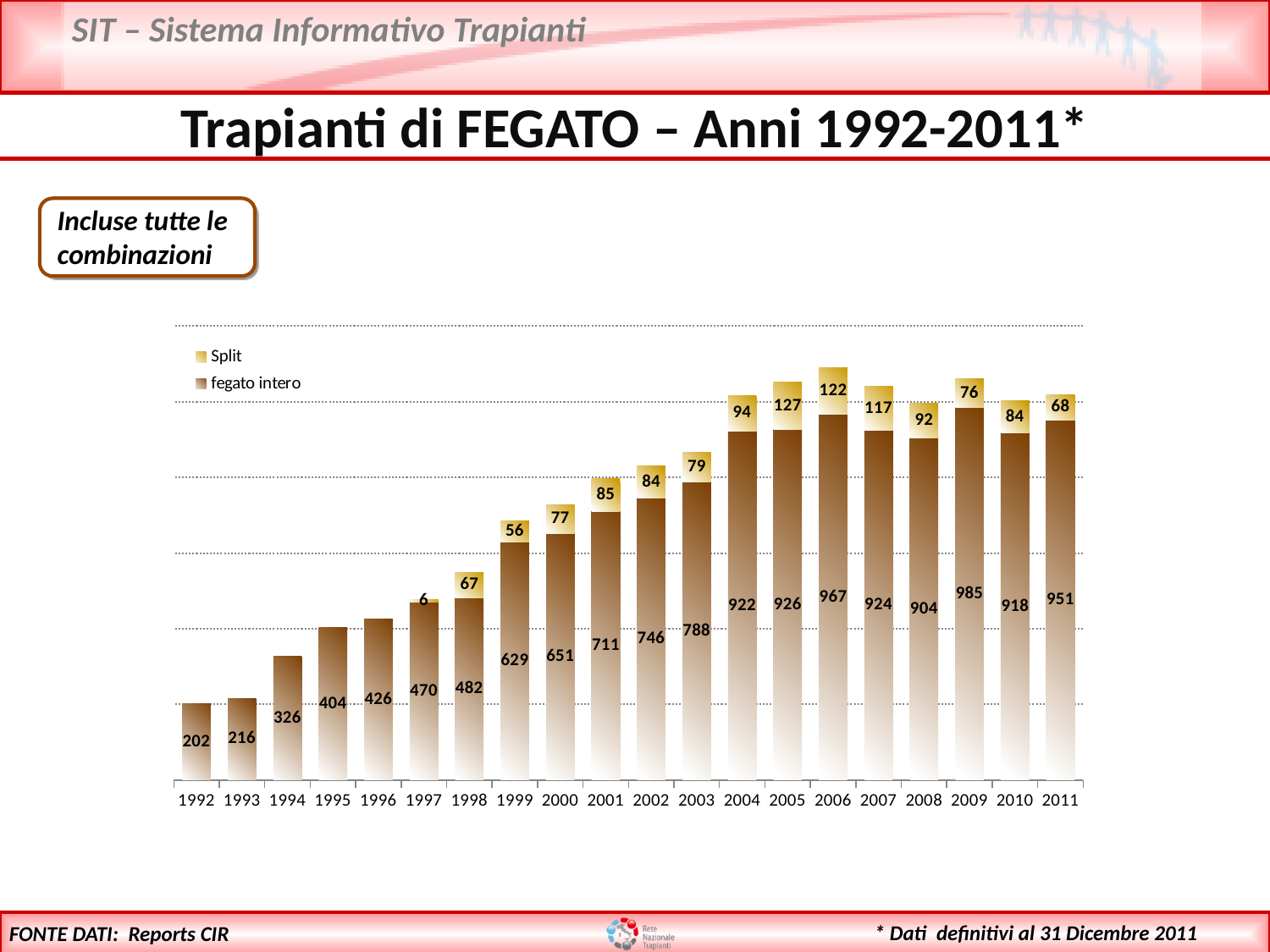
What is the total of the stacked bar for 2006? 1089 What is the 'Split' value for 2005? 127 What is the value of 'fegato intero' for 2006? 967 How many series does the legend list? 2 How many years are shown on the x axis? 20 What kind of chart is shown on the slide? Stacked bar chart Which year has the highest 'fegato intero' value? 2009 Which is larger, the 'fegato intero' value for 2004 or for 2008? 2004 Which year has the highest 'Split' value? 2005 What is the difference between the 'fegato intero' values for 2011 and 2010? 33 Which year has the lowest 'fegato intero' value? 1992 What is the 'fegato intero' value for 1992? 202